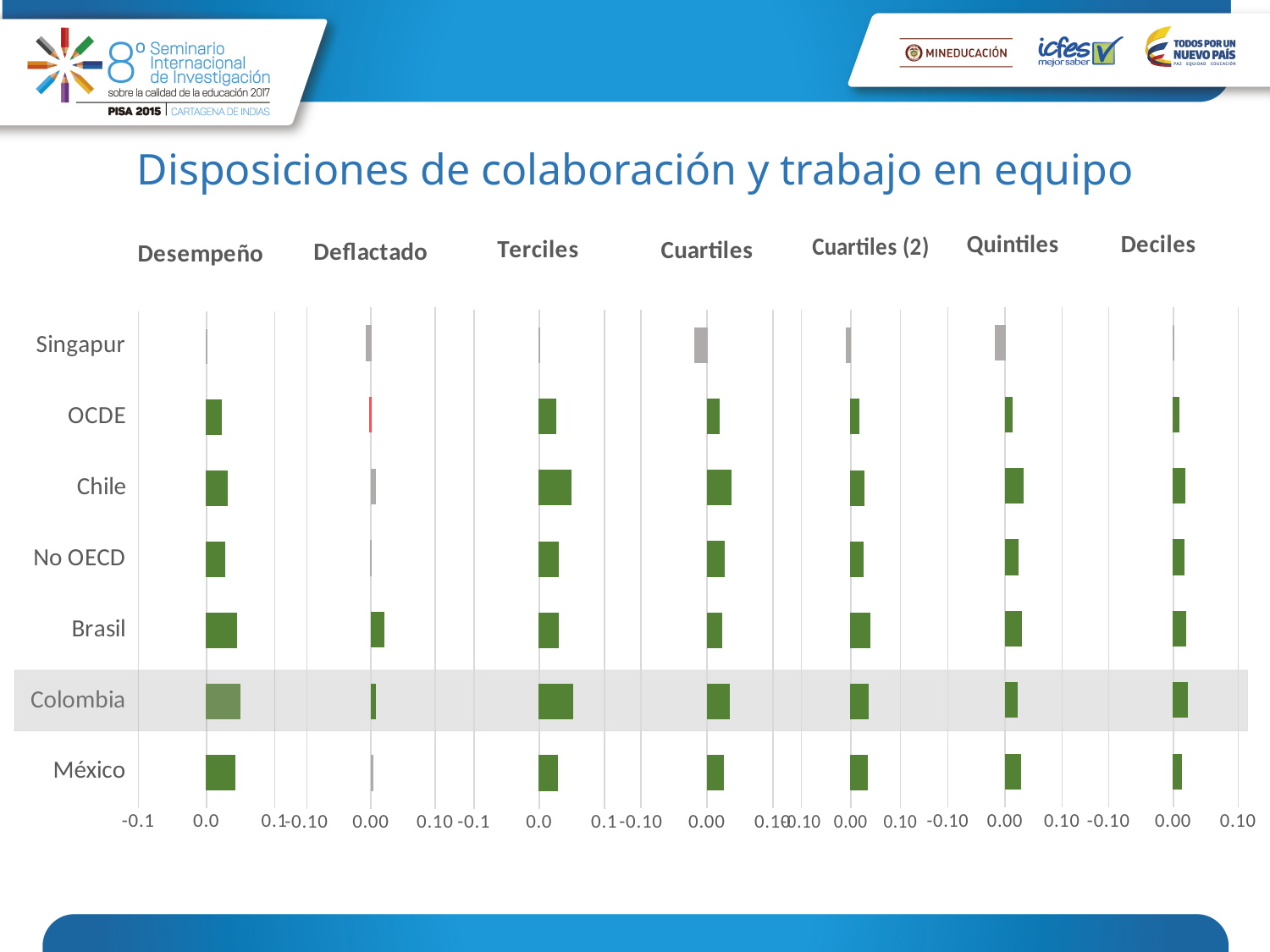
In the Deflactado chart, which category has the highest value? Brasil In the Desempeño chart, which is larger, the value for Brasil or the value for OCDE? Brasil In the Desempeño chart, is the value for Colombia greater or less than 0.0? greater How many country/group categories are listed on the vertical axis of the charts? 7 Which category row is highlighted with a grey band across the charts? Colombia In the Deflactado chart, which is larger, the value for Brasil or the value for Colombia? Brasil What is the title of the slide above the charts? Disposiciones de colaboración y trabajo en equipo In the Cuartiles chart, is the value for Singapur greater or less than 0.00? less How many small charts are shown on the slide? 7 What kind of chart is used for the Desempeño panel? bar chart In the Quintiles chart, which category has the lowest value? Singapur